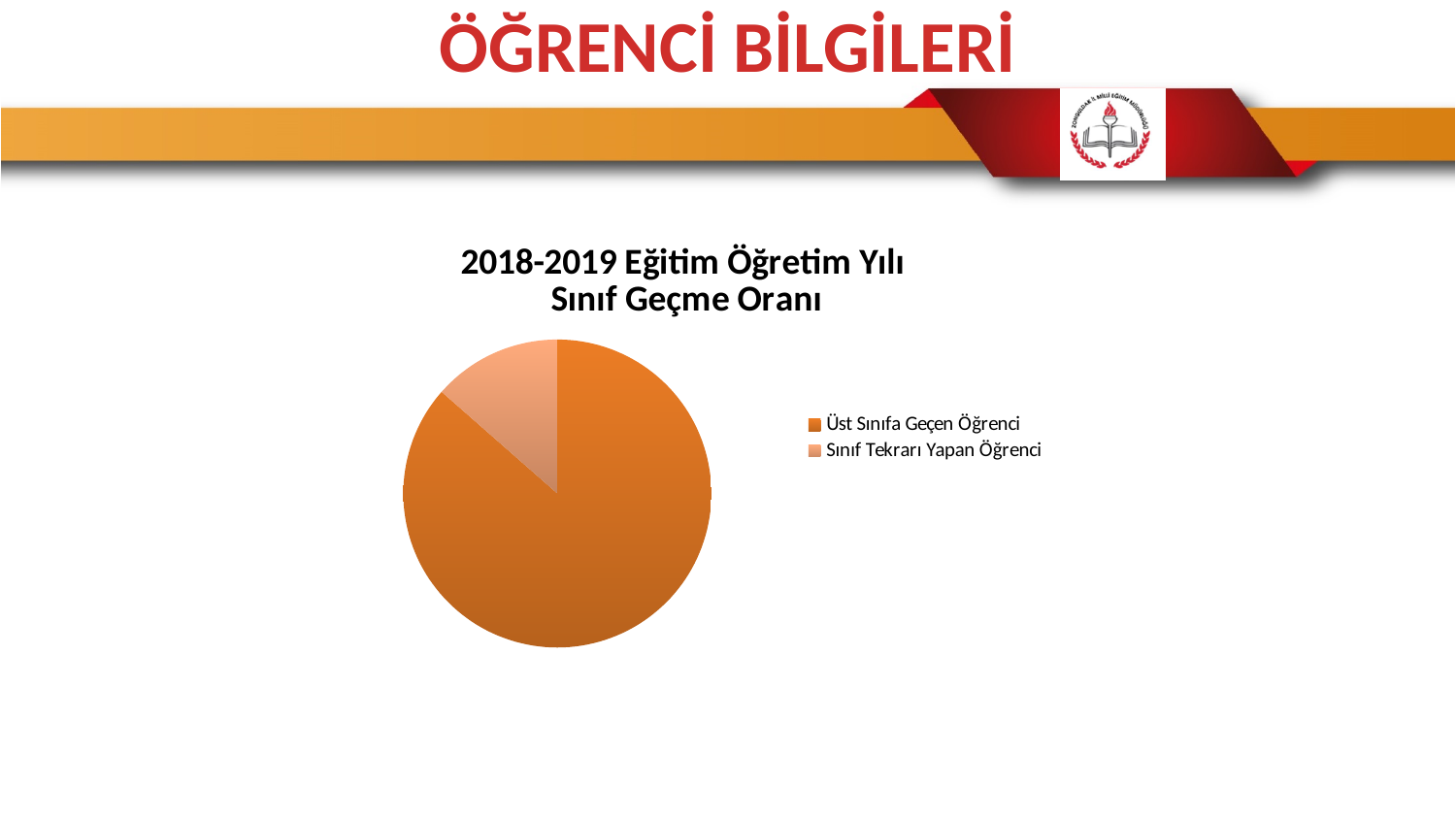
How many entries does the legend list? 2 What kind of chart is shown on the slide? pie chart Which category has the smallest slice of the pie? Sınıf Tekrarı Yapan Öğrenci Which category has the largest slice of the pie? Üst Sınıfa Geçen Öğrenci Which legend entry is shown in the lighter orange colour? Sınıf Tekrarı Yapan Öğrenci How many slices does the pie chart have? 2 Which is larger: the slice for Üst Sınıfa Geçen Öğrenci or the slice for Sınıf Tekrarı Yapan Öğrenci? Üst Sınıfa Geçen Öğrenci What is the title of the chart? 2018-2019 Eğitim Öğretim Yılı Sınıf Geçme Oranı